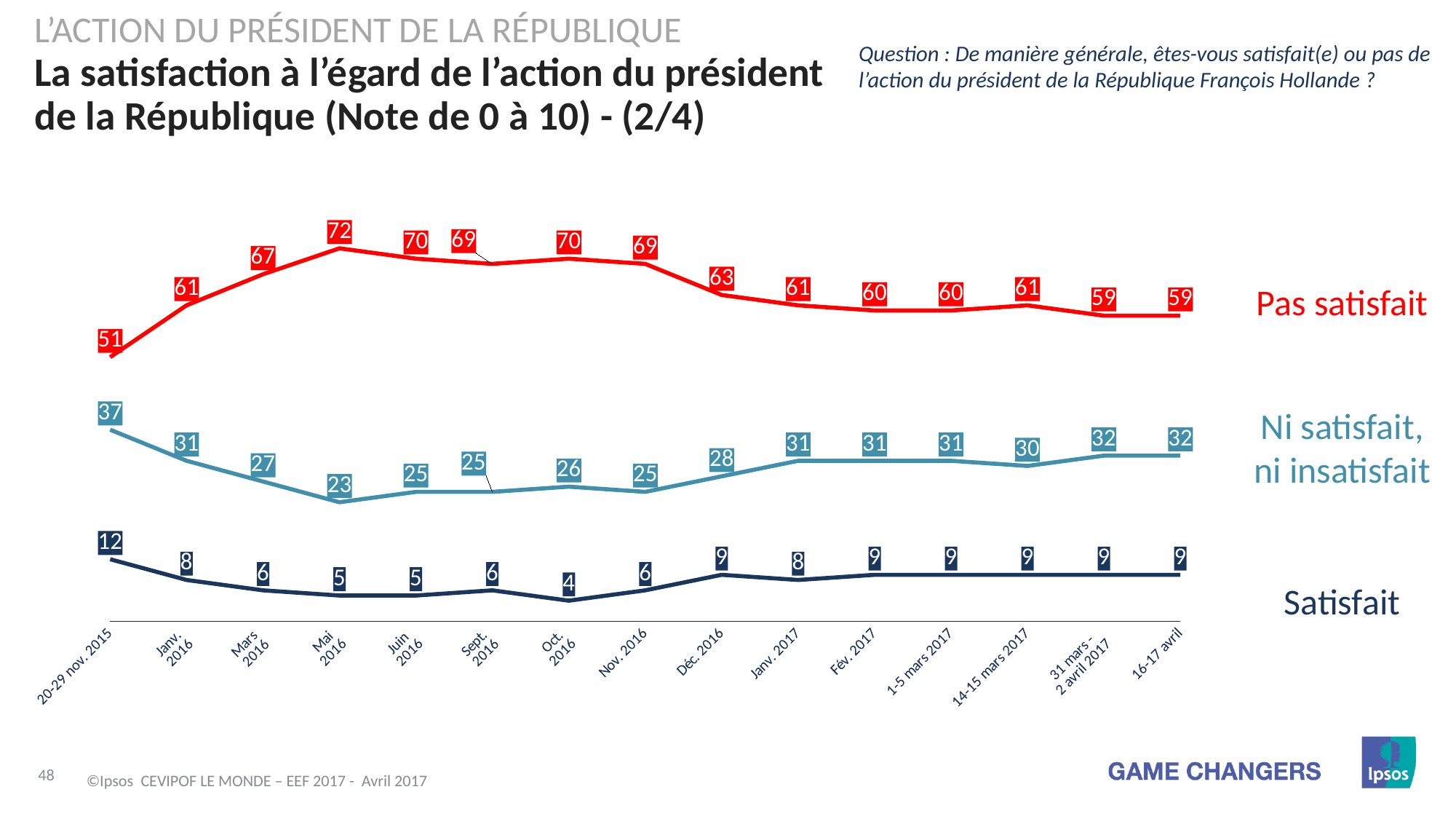
At which time point is 'Satisfait' at its lowest value? Oct. 2016 Which series is drawn in red? Pas satisfait How many time points are plotted along the x axis? 15 What is the difference between the 'Pas satisfait' value in Mai 2016 and at 20-29 nov. 2015? 21 What type of chart is shown on the slide? line chart Which is larger: 'Ni satisfait, ni insatisfait' at 20-29 nov. 2015 or in Mai 2016? 20-29 nov. 2015 At which time point does 'Pas satisfait' reach its highest value? Mai 2016 What is the value for 'Ni satisfait, ni insatisfait' in Déc. 2016? 28 Does the 'Satisfait' series rise or fall between 20-29 nov. 2015 and Mai 2016? fall How many series does the chart show? 3 What is the value for 'Satisfait' at 20-29 nov. 2015? 12 What is the value for 'Pas satisfait' in Mai 2016? 72